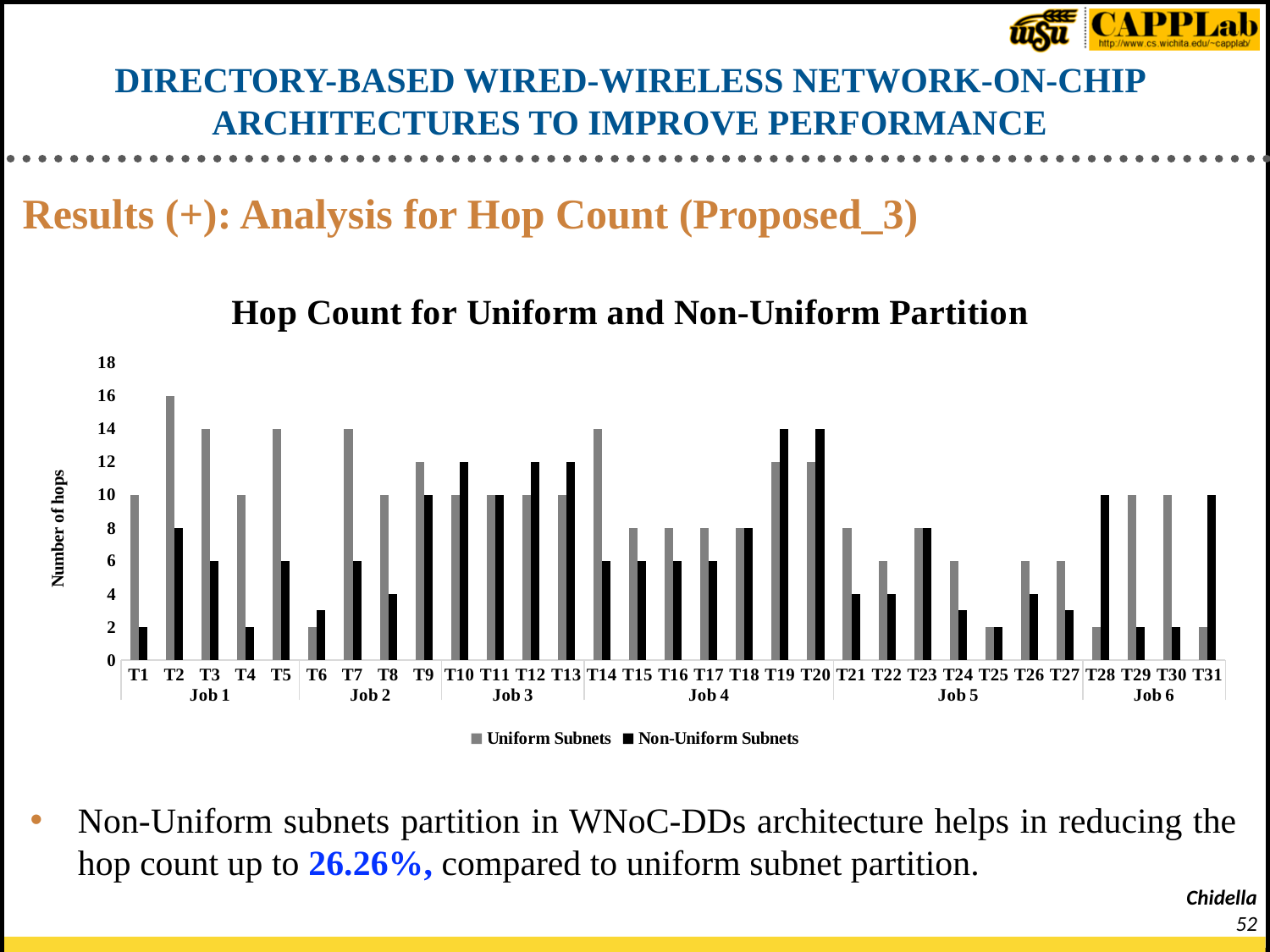
For T28, which series has the larger hop count, Uniform Subnets or Non-Uniform Subnets? Non-Uniform Subnets What is the difference between the Uniform Subnets and Non-Uniform Subnets hop counts for T2? 8 How many job groups are the tasks divided into on the x axis? 6 Which task has the highest Uniform Subnets hop count? T2 What kind of chart is shown on the slide? Bar chart How many series does the legend list? 2 Is the Uniform Subnets value for T6 greater or less than 4? less How many tasks (T1 to T31) are shown on the x axis? 31 What is the Non-Uniform Subnets hop count for T1? 2 Is the Non-Uniform Subnets value for T19 greater or less than 12? greater What is the Uniform Subnets hop count for T2? 16 What is the title of the chart? Hop Count for Uniform and Non-Uniform Partition